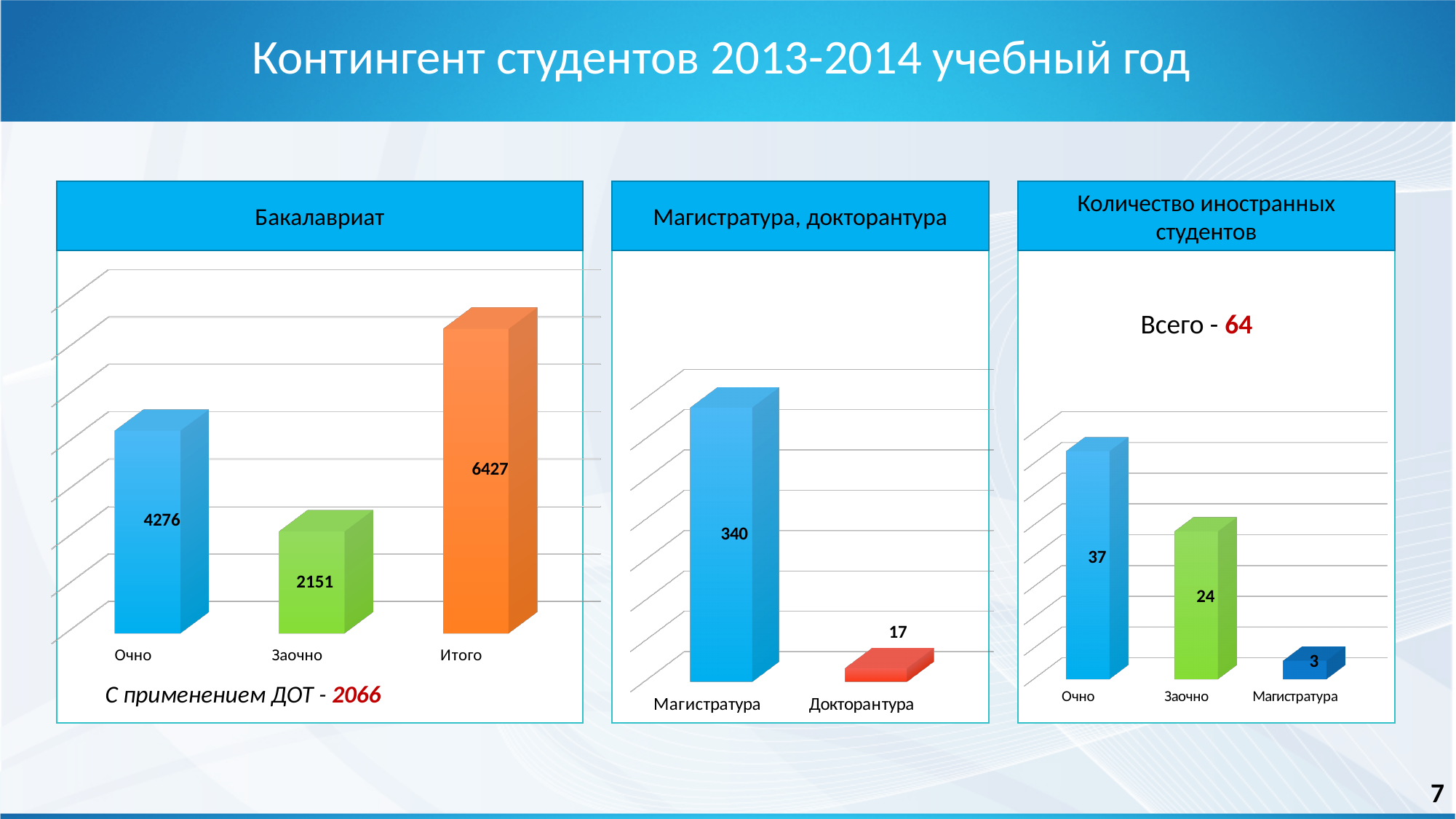
In the "Количество иностранных студентов" chart, what is the value for Заочно? 24 In the "Количество иностранных студентов" chart, which is larger, Очно or Магистратура? Очно In the "Количество иностранных студентов" chart, how many categories are plotted? 3 In the "Магистратура, докторантура" chart, how many categories are plotted? 2 What kind of chart is the "Бакалавриат" chart? Bar chart In the "Бакалавриат" chart, which category has the highest value? Итого In the "Бакалавриат" chart, what is the value for Очно? 4276 In the "Количество иностранных студентов" chart, what is the difference between Очно and Заочно? 13 In the "Магистратура, докторантура" chart, which category has the lowest value? Докторантура In the "Бакалавриат" chart, what is the difference between Очно and Заочно? 2125 In the "Магистратура, докторантура" chart, what is the value for Докторантура? 17 In the "Бакалавриат" chart, what is the value for Заочно? 2151